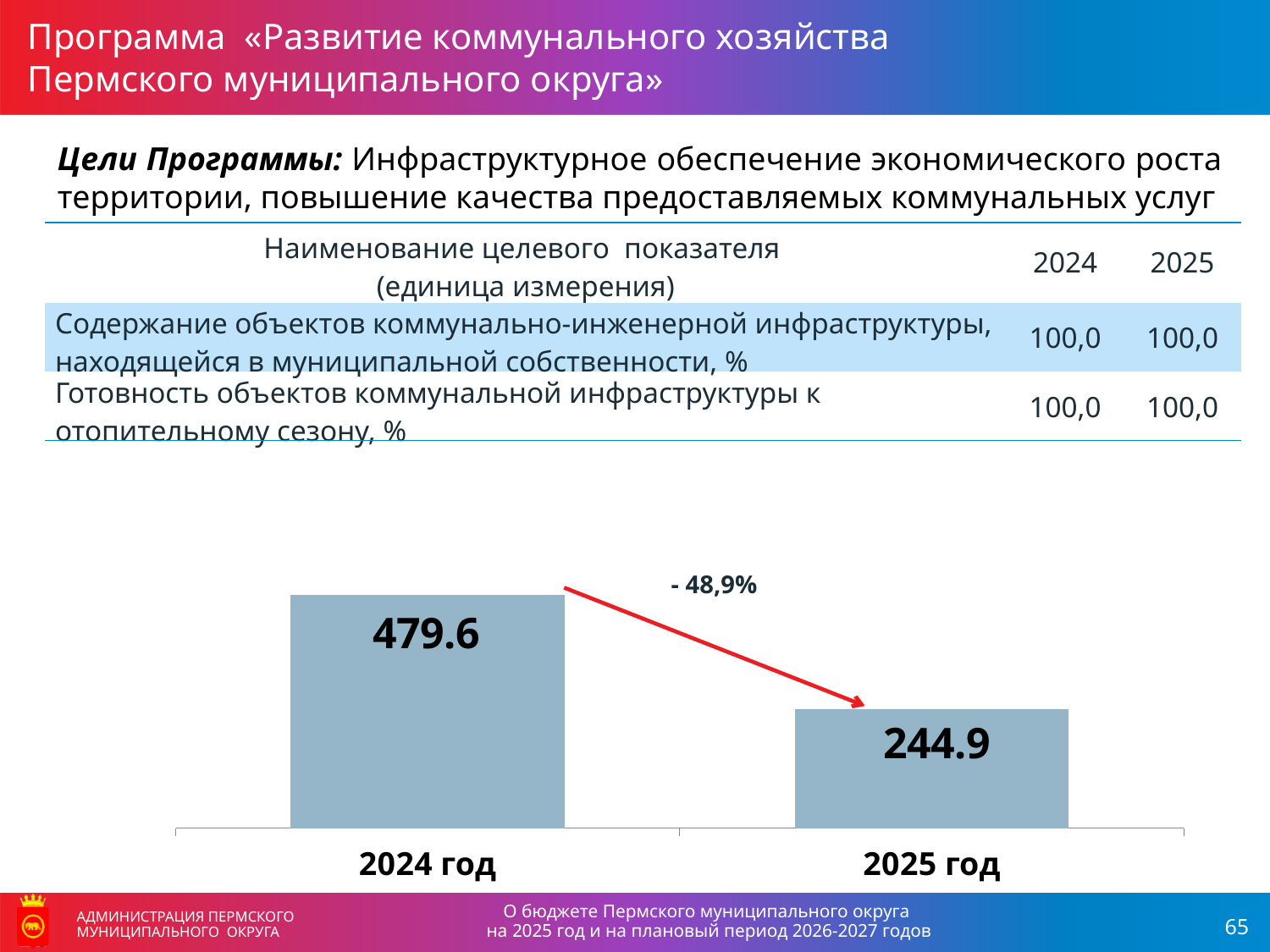
What percentage change is annotated on the arrow between the two bars? - 48,9% What is the value shown for 2025 год in the bar chart? 244.9 Do the values in the chart rise or fall from 2024 год to 2025 год? fall Which category has the highest value in the bar chart? 2024 год What kind of chart is shown on the slide? bar chart Which category has the lowest value in the bar chart? 2025 год What is the difference between the values for 2024 год and 2025 год in the bar chart? 234.7 How many bars are plotted in the chart? 2 What colour are the bars in the chart? grey-blue What is the value shown for 2024 год in the bar chart? 479.6 Which is larger in the bar chart, the value for 2024 год or for 2025 год? 2024 год